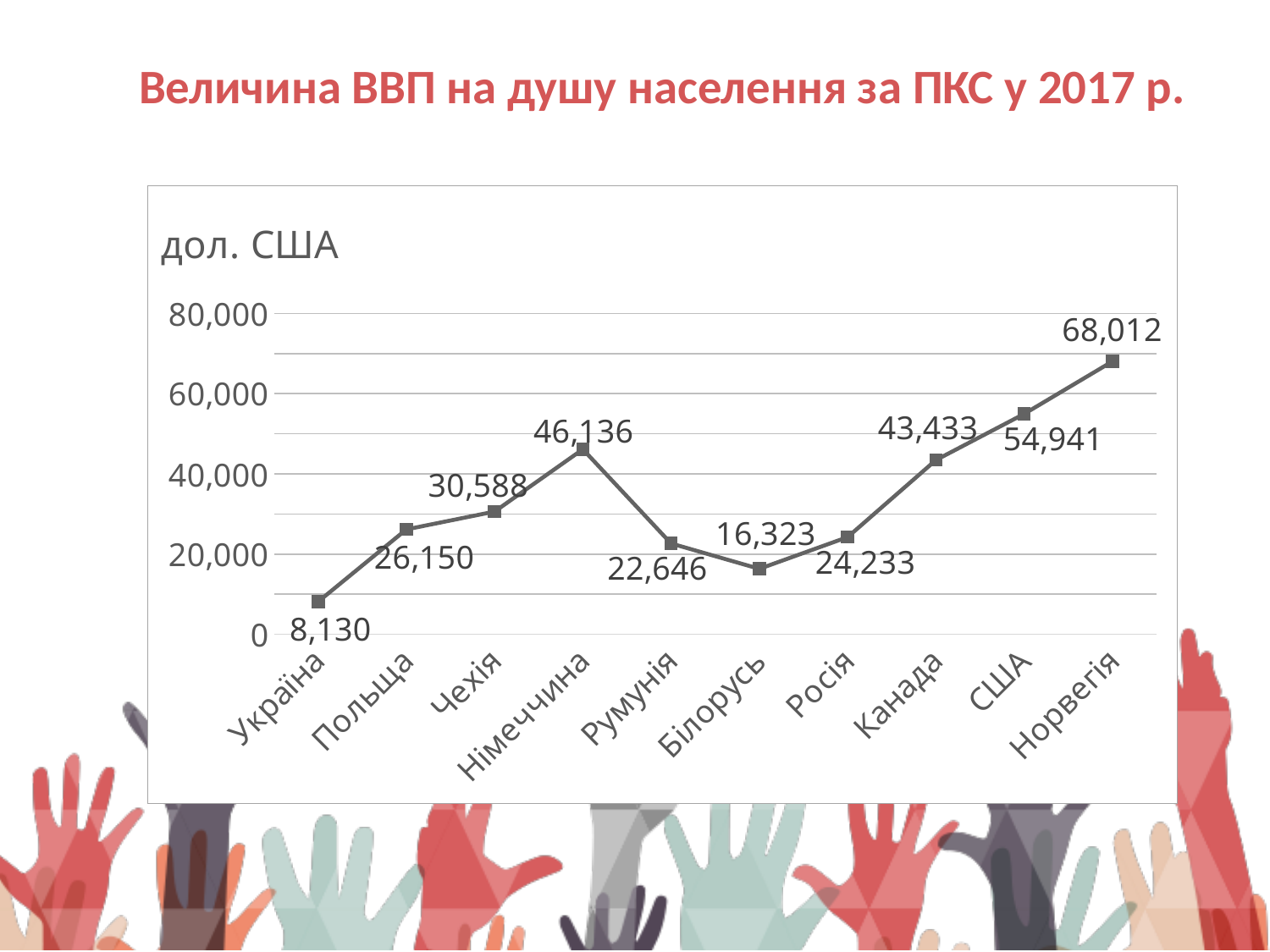
Which has a larger value, Румунія or Росія? Росія What is the difference between the values for Польща and Україна? 18,020 Which country has the highest value on the chart? Норвегія Is the value for Чехія greater or less than 40,000? less How many countries are plotted on the chart? 10 What is the GDP per capita value shown for Україна? 8,130 Which country has the lowest value on the chart? Україна What unit label is shown at the top of the chart? дол. США What is the difference between the values for Норвегія and США? 13,071 What kind of chart is shown on the slide? line chart What value is shown for Канада? 43,433 What value is shown for Німеччина? 46,136